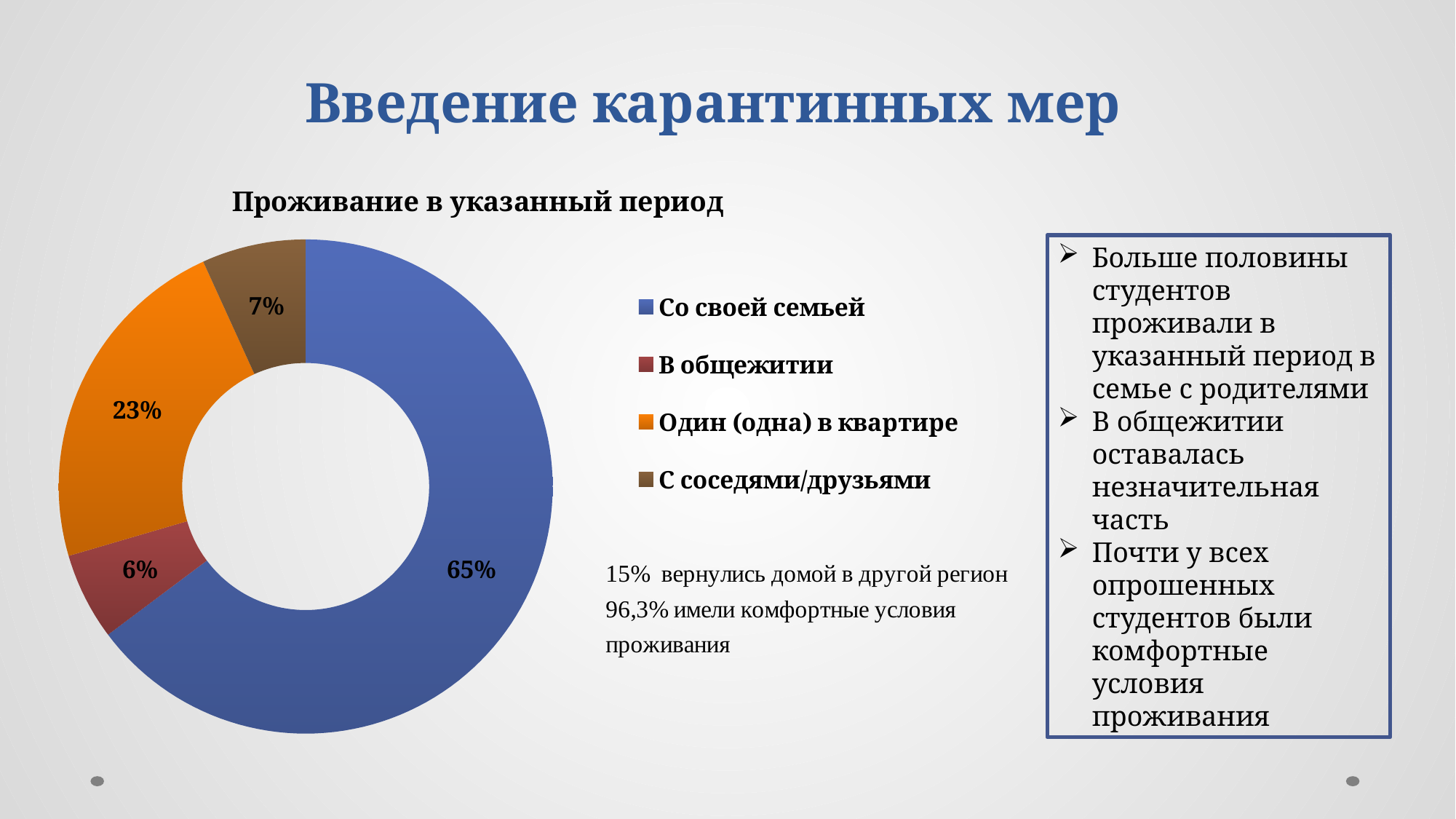
Which category has the smallest share of the chart? В общежитии What share of the chart does "Со своей семьей" represent? 65% What kind of chart is shown on the slide? Doughnut (pie) chart How many categories are shown in the chart? 4 Which is larger: the share for "С соседями/друзьями" or for "В общежитии"? С соседями/друзьями What is the value shown for "С соседями/друзьями"? 7% What is the value shown for "В общежитии"? 6% Which colour represents "Один (одна) в квартире" in the chart? Orange What is the difference between the shares for "Со своей семьей" and "Один (одна) в квартире"? 42% What is the title of the chart? Проживание в указанный период What is the value shown for "Один (одна) в квартире"? 23% Which category has the largest share of the chart? Со своей семьей